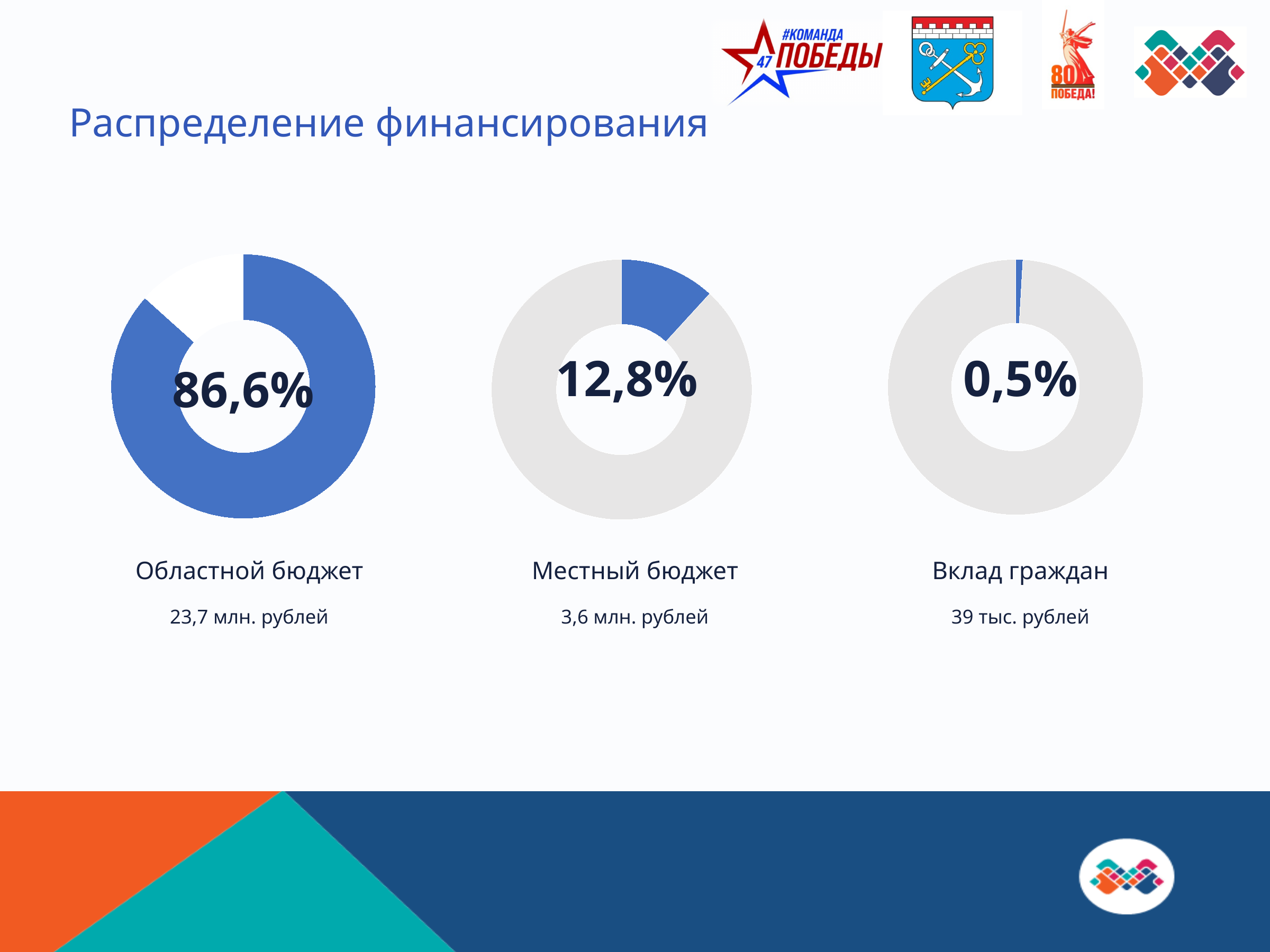
Which share is larger, Местный бюджет or Вклад граждан? Местный бюджет What percentage is shown in the donut chart for Местный бюджет? 12,8% What amount in rubles is listed under the Местный бюджет chart? 3,6 млн. рублей How many donut charts are shown on the slide? 3 What is the difference in percentage points between the Областной бюджет share and the Местный бюджет share? 73,8 What percentage is shown in the donut chart for Областной бюджет? 86,6% Which funding source has the highest share on the slide? Областной бюджет What amount in rubles is listed under the Вклад граждан chart? 39 тыс. рублей What percentage is shown in the donut chart for Вклад граждан? 0,5% What amount in rubles is listed under the Областной бюджет chart? 23,7 млн. рублей Which funding source has the lowest share on the slide? Вклад граждан What is the title of the slide? Распределение финансирования